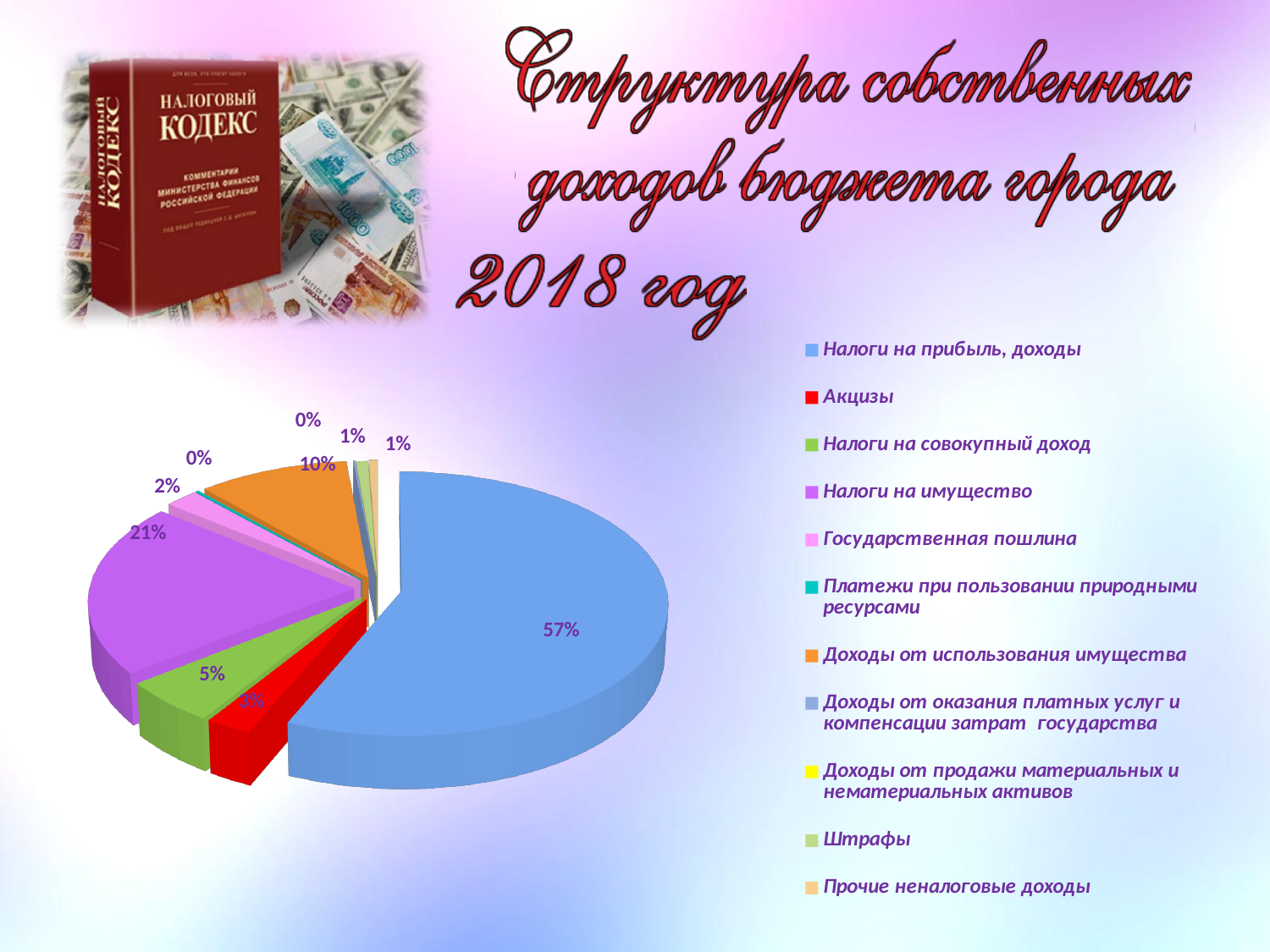
What is the difference between the shares of "Налоги на прибыль, доходы" and "Налоги на имущество"? 36 percentage points What type of chart is shown on the slide? pie chart What is the value shown for "Акцизы"? 3% What is the value shown for "Налоги на совокупный доход"? 5% What is the value shown for "Государственная пошлина"? 2% What is the value shown for "Налоги на имущество"? 21% How many categories does the legend list? 11 Which is larger: the share of "Налоги на имущество" or the share of "Доходы от использования имущества"? Налоги на имущество What share of the pie does "Налоги на прибыль, доходы" take? 57% What is the value shown for "Доходы от использования имущества"? 10% What colour is the slice for "Акцизы"? red Which category has the largest share of the pie? Налоги на прибыль, доходы